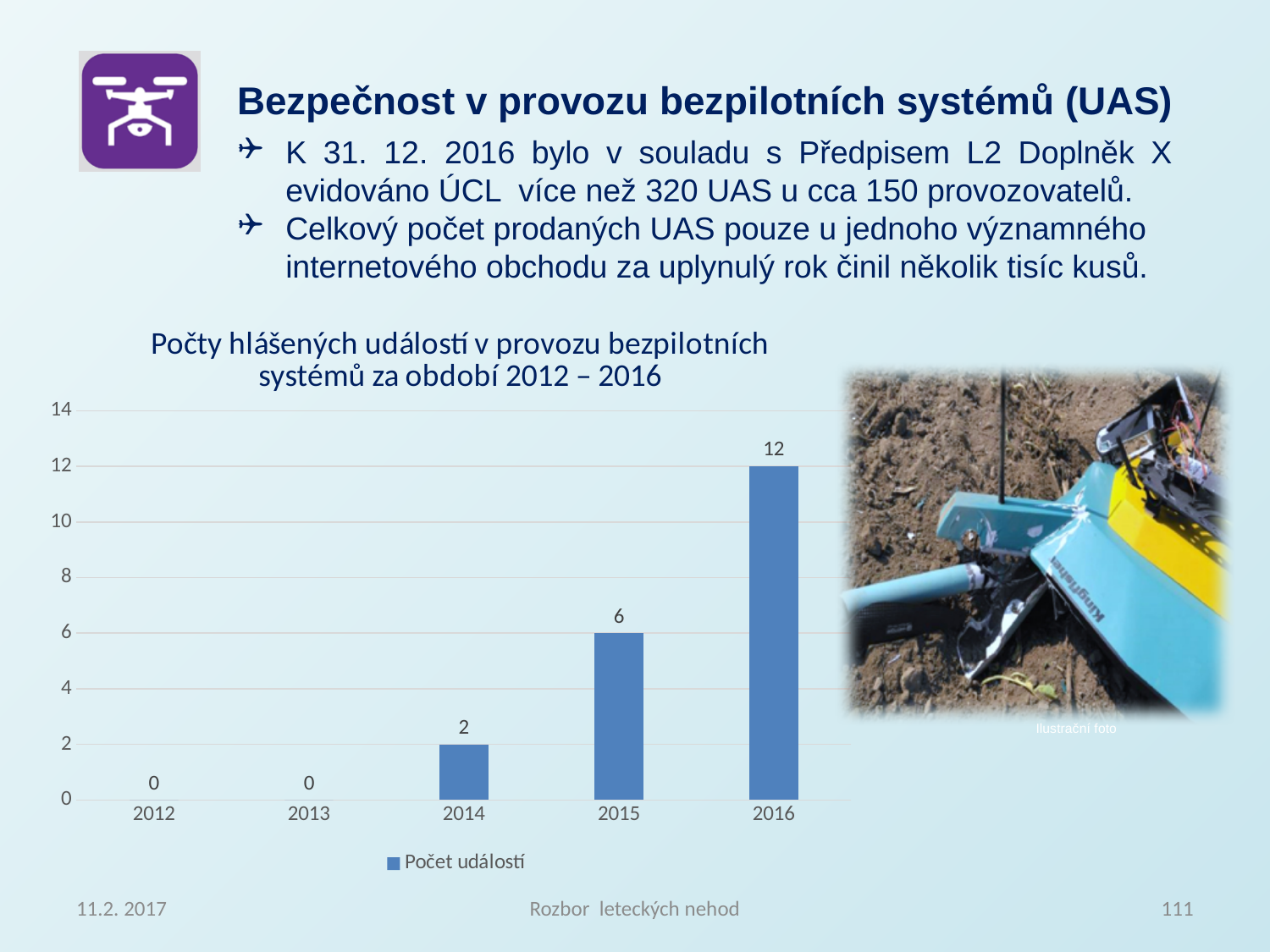
Is the value for 2016 greater or less than 10? greater How many series does the chart legend list? 1 What is the value for 2012 in the chart? 0 What is the difference between the values for 2015 and 2014? 4 What is the difference between the values for 2016 and 2015? 6 What is the value for 2014 in the chart? 2 What kind of chart is shown on the slide? bar chart Do the values rise or fall from 2012 to 2016? rise How many years are shown on the x axis of the chart? 5 What is the value for 2016 in the chart? 12 Which year has the highest number of reported events? 2016 Which is larger, the value for 2015 or the value for 2014? 2015